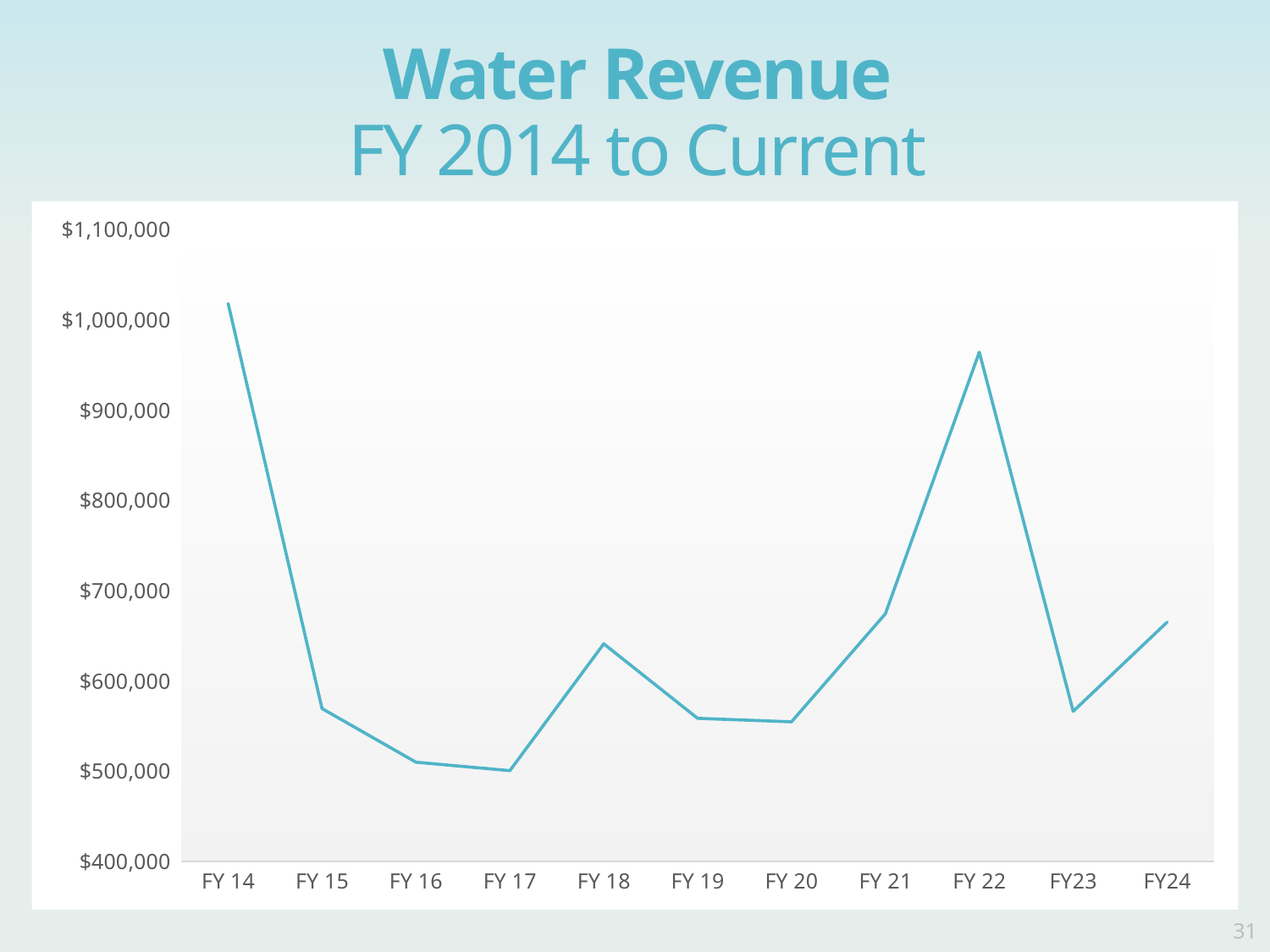
Which fiscal year has the highest water revenue? FY 14 What is the title of the chart? Water Revenue FY 2014 to Current Is the water revenue for FY 18 greater or less than $600,000? greater How many fiscal years are plotted on the x axis? 11 Is the water revenue for FY 14 greater or less than $1,000,000? greater What kind of chart is shown on the slide? line chart Is the water revenue for FY 21 greater or less than $700,000? less Which has the higher water revenue, FY 22 or FY23? FY 22 Does water revenue rise or fall from FY 14 to FY 17? fall Which has the higher water revenue, FY 14 or FY 22? FY 14